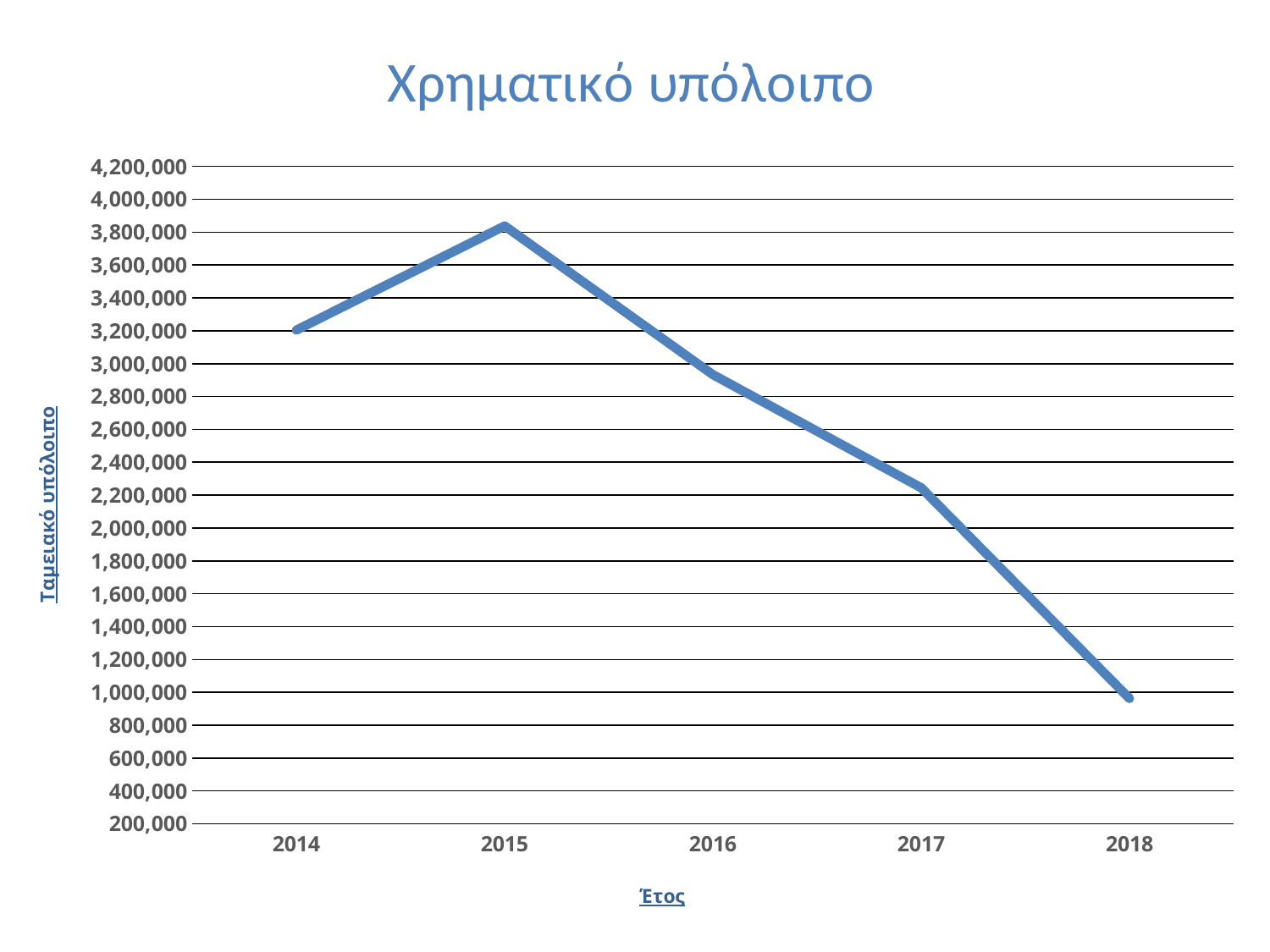
Do the values rise or fall from 2015 to 2018? fall In which year is the value highest? 2015 In which year is the value lowest? 2018 Is the value for 2017 greater or less than 2,000,000? greater Is the value for 2018 greater or less than 1,200,000? less Which year has the larger value, 2014 or 2018? 2014 What kind of chart is shown on the slide? line chart What is the title of the chart? Χρηματικό υπόλοιπο Which year has the larger value, 2016 or 2017? 2016 What is the label of the x axis? Έτος How many years are plotted on the x axis? 5 Is the value for 2015 greater or less than 3,600,000? greater